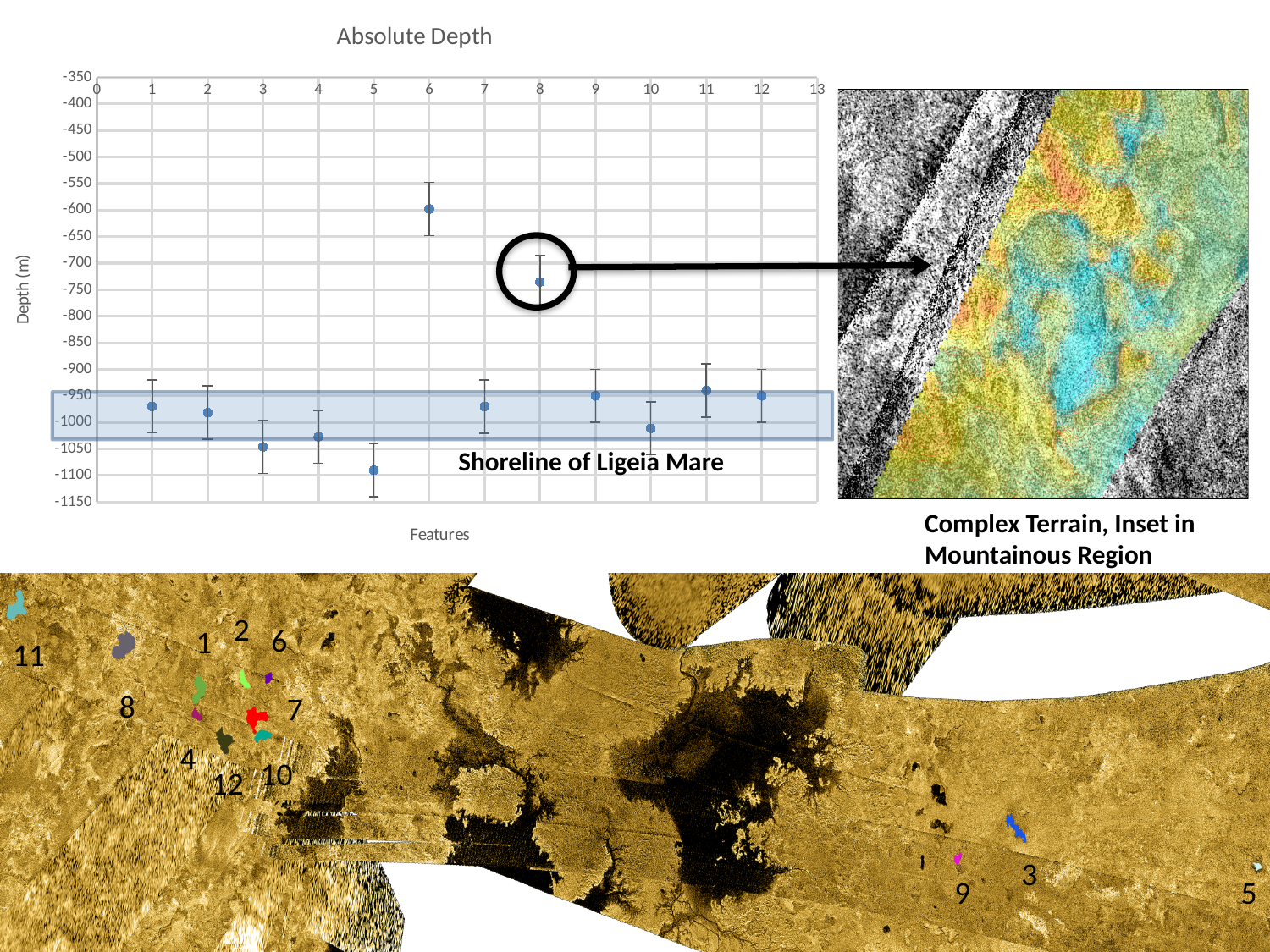
What label is written on the shaded horizontal band in the chart? Shoreline of Ligeia Mare Which has the larger depth value, feature 6 or feature 8? feature 6 Which feature has the highest (least negative) depth value in the chart? 6 Is the depth value for feature 6 greater or less than -700? greater Which feature has the lowest (most negative) depth value in the chart? 5 Is the depth value for feature 3 greater or less than -1000? less How many data points are plotted in the Absolute Depth chart? 12 What kind of chart is shown on the slide? scatter chart Is the depth value for feature 8 greater or less than -800? greater What is the title of the chart? Absolute Depth Which has the larger depth value, feature 1 or feature 5? feature 1